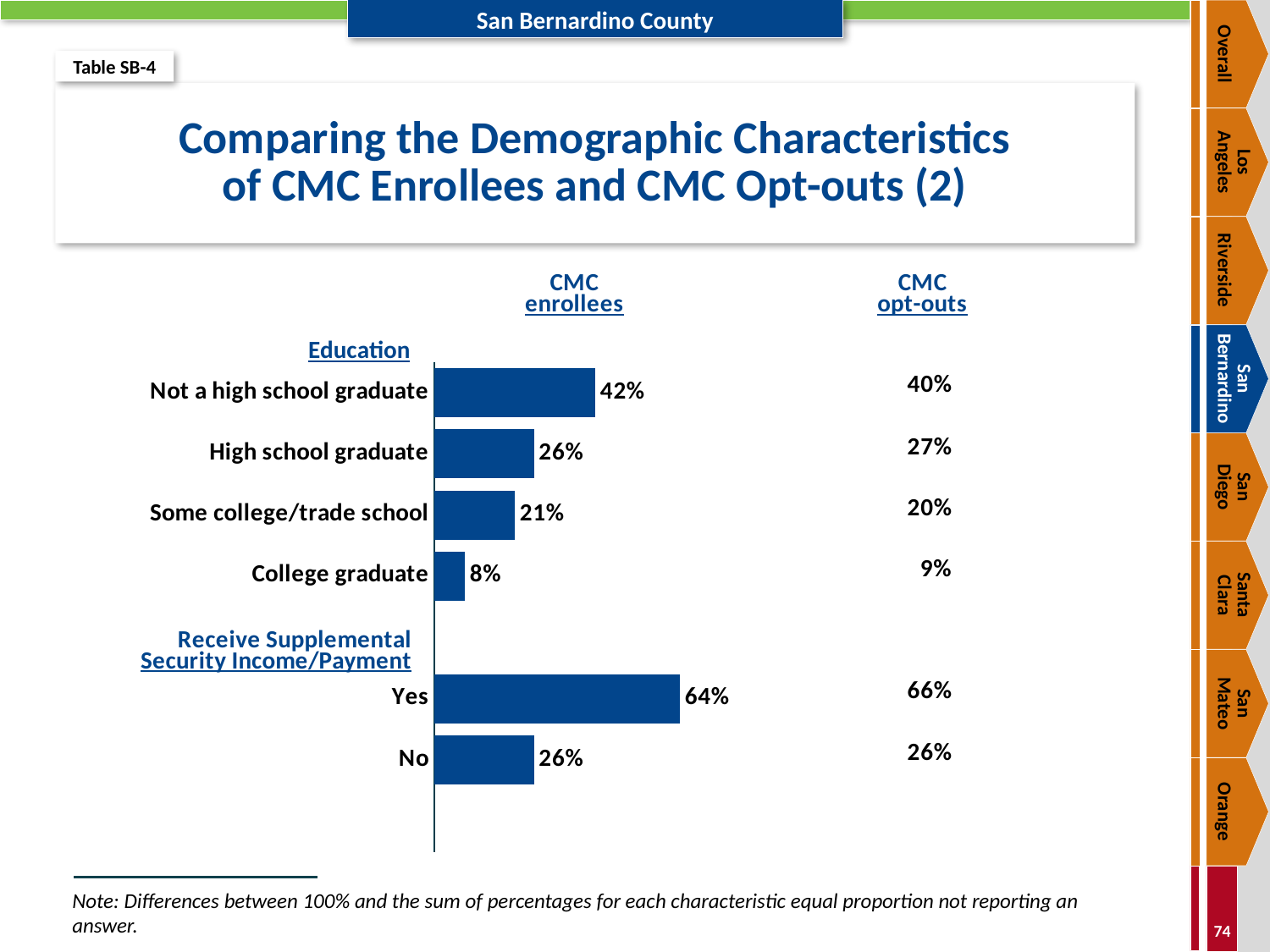
What is the difference in percentage points between CMC enrollees who are not a high school graduate and those who are high school graduates? 16 percentage points How many bars are plotted in the CMC enrollees chart? 6 Do the CMC enrollees values decrease from 'Not a high school graduate' down to 'College graduate'? Yes Which education category has the lowest value among CMC enrollees? College graduate Which bar in the CMC enrollees chart has the highest value? Yes (Receive Supplemental Security Income/Payment) What percentage of CMC enrollees are college graduates? 8% What kind of chart is used to show the CMC enrollees values? Bar chart What is the title of the slide's chart? Comparing the Demographic Characteristics of CMC Enrollees and CMC Opt-outs (2) Which is larger: the share of CMC enrollees or CMC opt-outs who are not a high school graduate? CMC enrollees What percentage of CMC enrollees are not a high school graduate? 42% What percentage of CMC opt-outs receive Supplemental Security Income/Payment (Yes)? 66% What percentage of CMC opt-outs have some college/trade school education? 20%